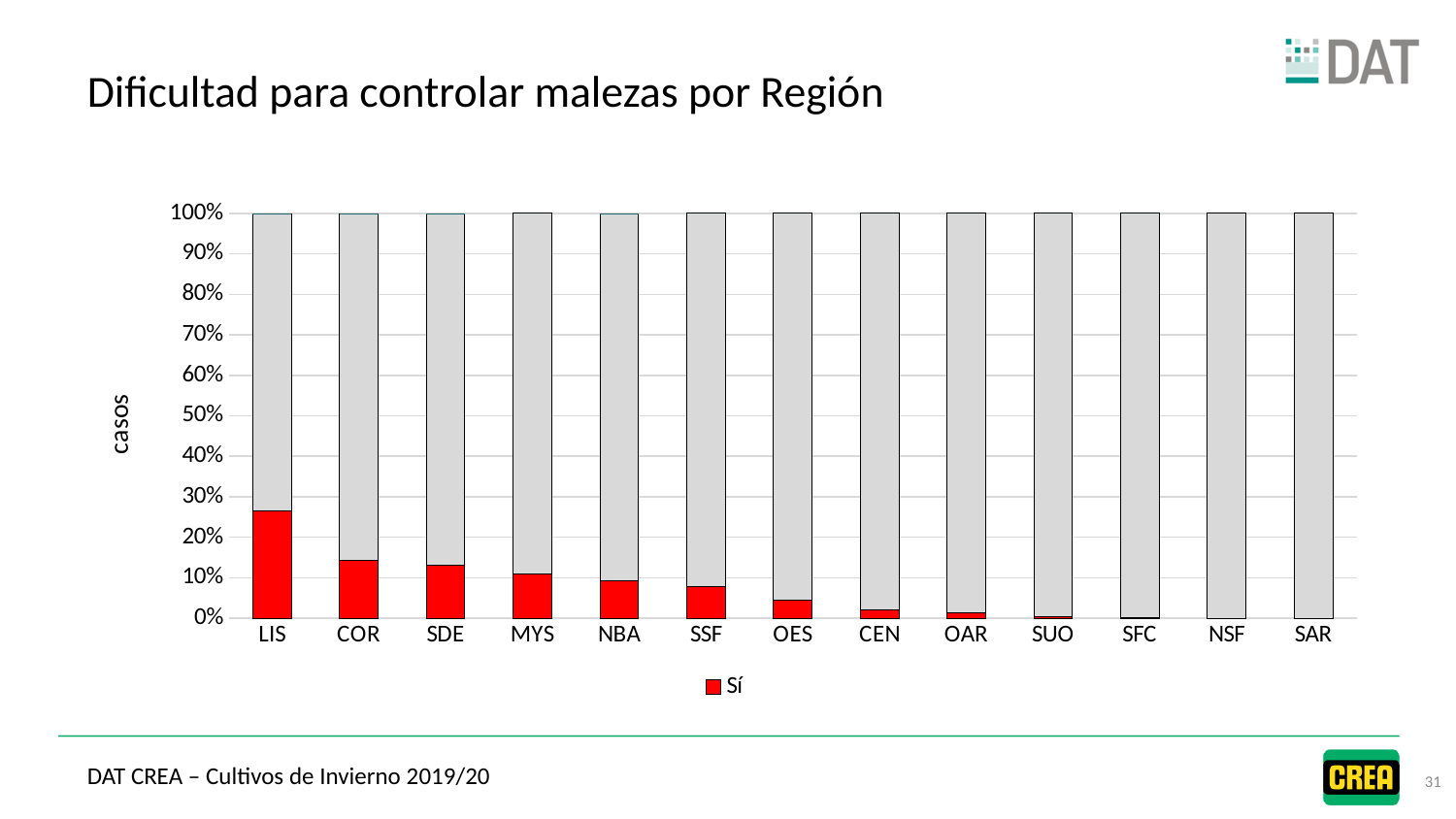
What is the title of the chart on the slide? Dificultad para controlar malezas por Región How many series does the chart legend list? 1 How many regions are shown on the x axis of the chart? 13 Is the red 'Sí' value for OES greater or less than 10%? less Which region has a larger red 'Sí' share, SDE or OES? SDE Which region has a larger red 'Sí' share, LIS or COR? LIS Do the red 'Sí' values rise or fall moving from left to right along the x axis? Fall Is the red 'Sí' value for LIS greater or less than 20%? greater Is the red 'Sí' value for CEN greater or less than 10%? less What kind of chart is shown on the slide? Bar chart Which region has the highest red 'Sí' share in the chart? LIS